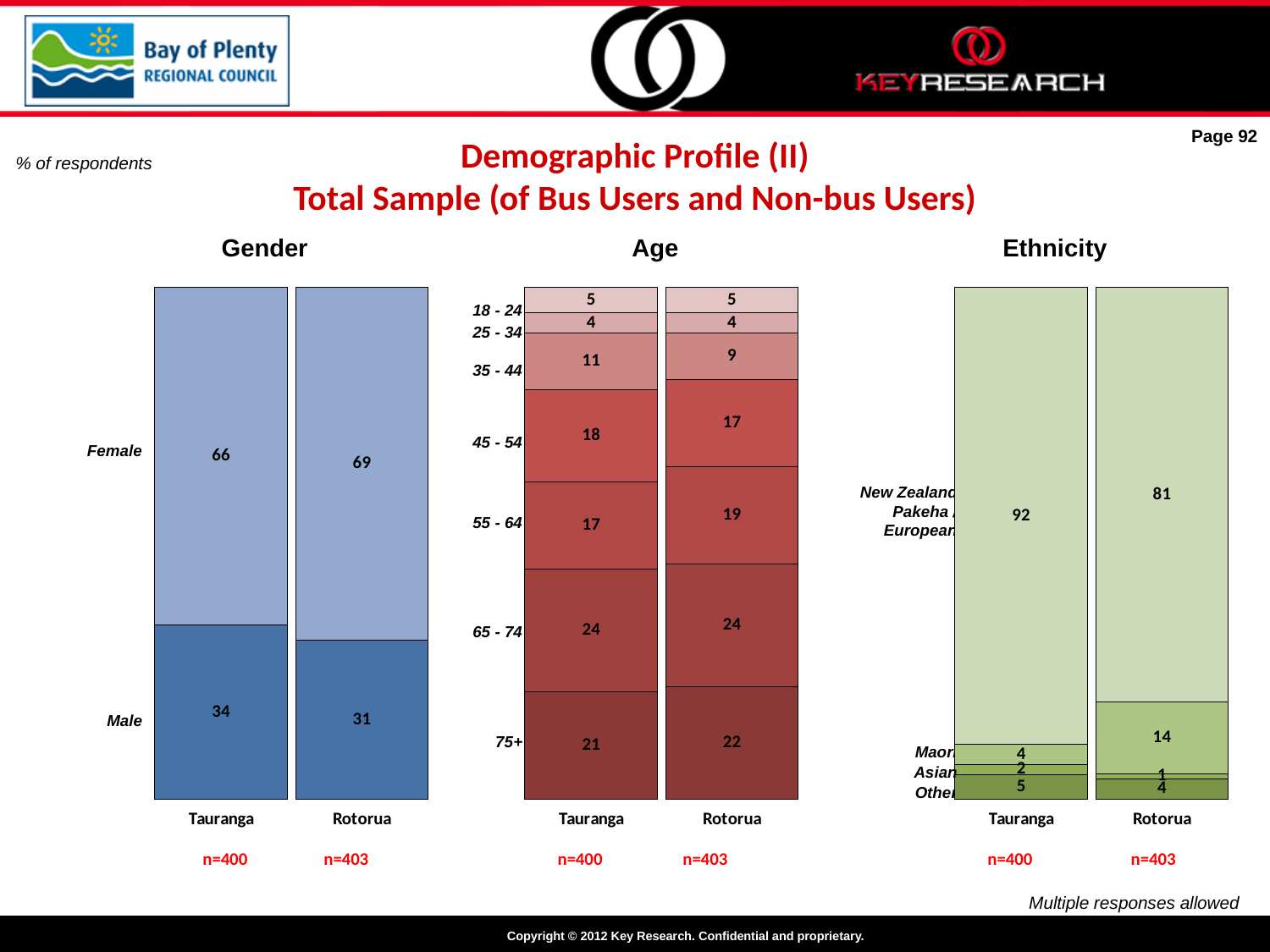
In the Ethnicity chart, what is the difference between the Maori values for Rotorua and Tauranga? 10 In the Age chart, what is the value for the 65 - 74 group in Tauranga? 24 In the Gender chart, what is the value for Male in Rotorua? 31 In the Ethnicity chart, what is the value for New Zealand Pakeha / European in Rotorua? 81 In the Gender chart, what is the difference between the Female values for Rotorua and Tauranga? 3 In the Age chart, which age group has the highest value for Tauranga? 65 - 74 In the Age chart, is the 55 - 64 value larger for Tauranga or Rotorua? Rotorua In the Gender chart, what is the value for Female in Tauranga? 66 What kind of chart is the Gender chart? Stacked bar chart In the Age chart, which age group has the lowest value for Rotorua? 25 - 34 In the Age chart, how many age groups are shown? 7 In the Ethnicity chart, what is the value for Maori in Tauranga? 4